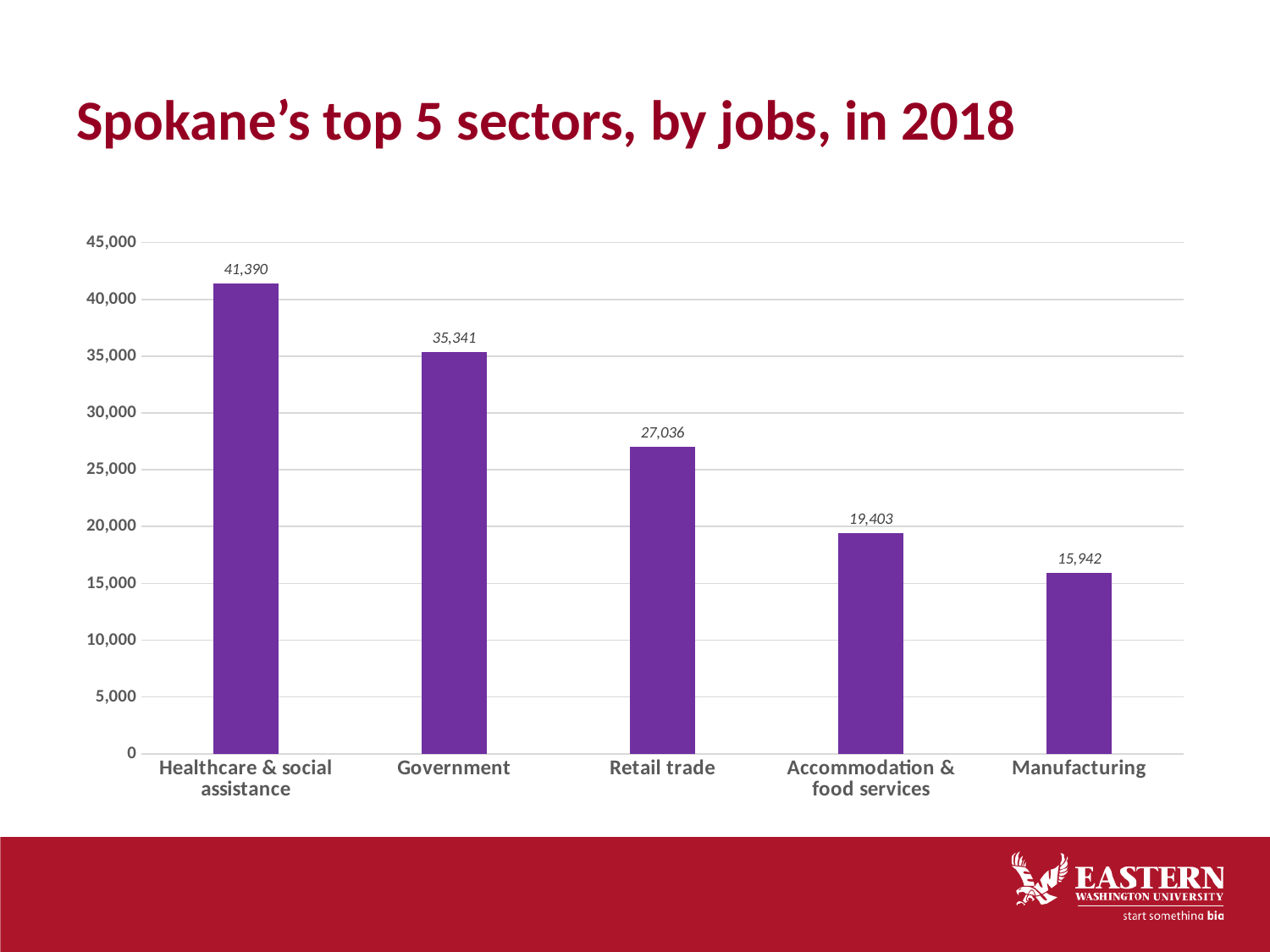
How many sectors are shown in the chart? 5 Is the value for Manufacturing greater or less than 20,000? less Which sector has the lowest number of jobs? Manufacturing What kind of chart is shown on the slide? Bar chart How many jobs does the Healthcare & social assistance sector have? 41,390 What is the difference in jobs between Healthcare & social assistance and Government? 6,049 What is the value shown for Retail trade? 27,036 What is the value shown for Government? 35,341 Which sector has the highest number of jobs? Healthcare & social assistance Which has more jobs, Retail trade or Accommodation & food services? Retail trade What is the value shown for Accommodation & food services? 19,403 What is the value shown for Manufacturing? 15,942